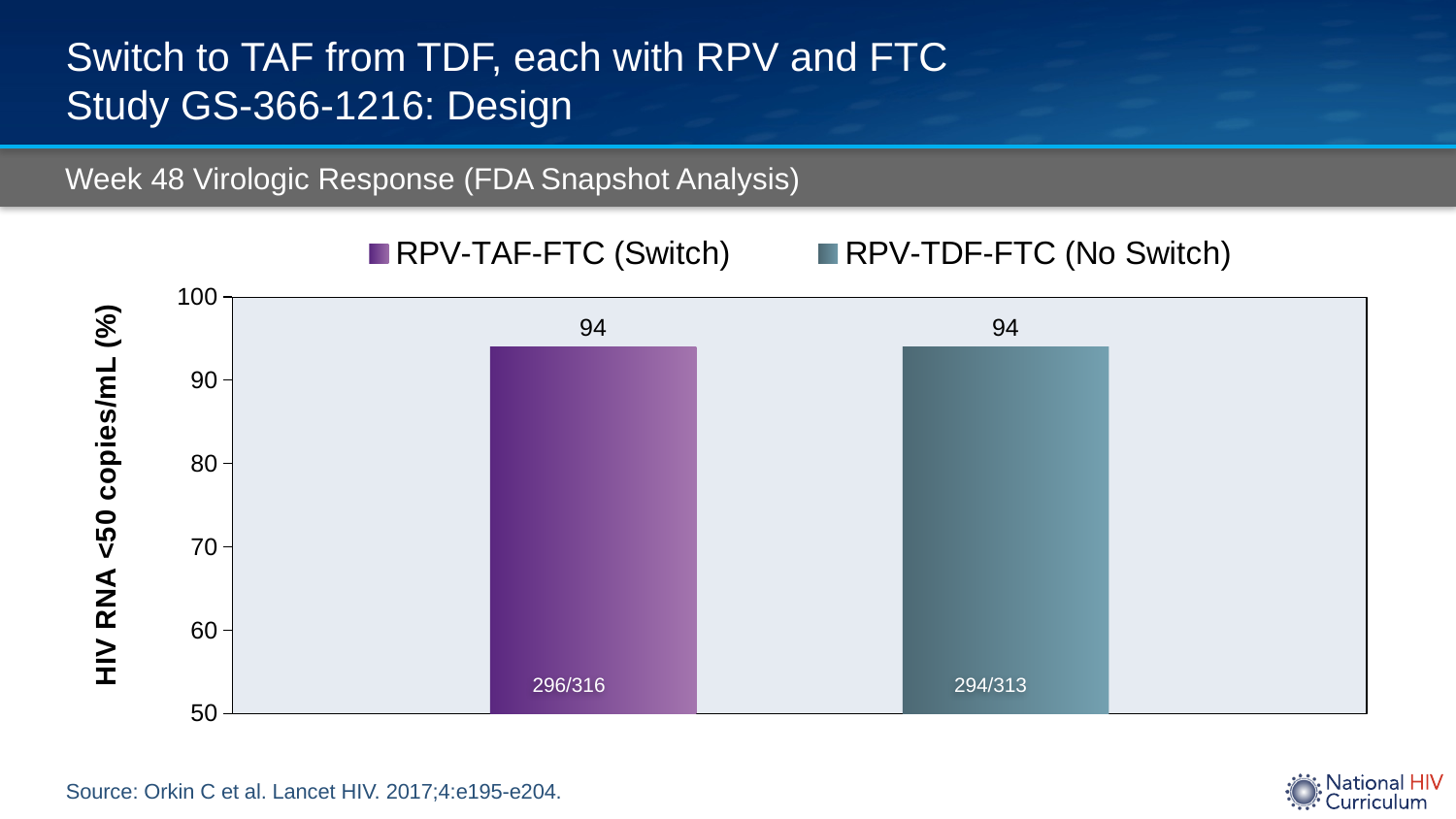
Is the value for RPV-TDF-FTC (No Switch) greater or less than 100? less What fraction is printed inside the RPV-TAF-FTC (Switch) bar? 296/316 What is the Week 48 virologic response value for RPV-TDF-FTC (No Switch)? 94 What fraction is printed inside the RPV-TDF-FTC (No Switch) bar? 294/313 What is the difference between the RPV-TAF-FTC (Switch) and RPV-TDF-FTC (No Switch) response values? 0 What is the title shown above the chart? Week 48 Virologic Response (FDA Snapshot Analysis) What is the Week 48 virologic response value for RPV-TAF-FTC (Switch)? 94 How many series does the legend list? 2 Is the value for RPV-TAF-FTC (Switch) greater or less than 90? greater What is the y-axis label of the chart? HIV RNA <50 copies/mL (%) How many bars are plotted in the chart? 2 What kind of chart is shown on the slide? Bar chart